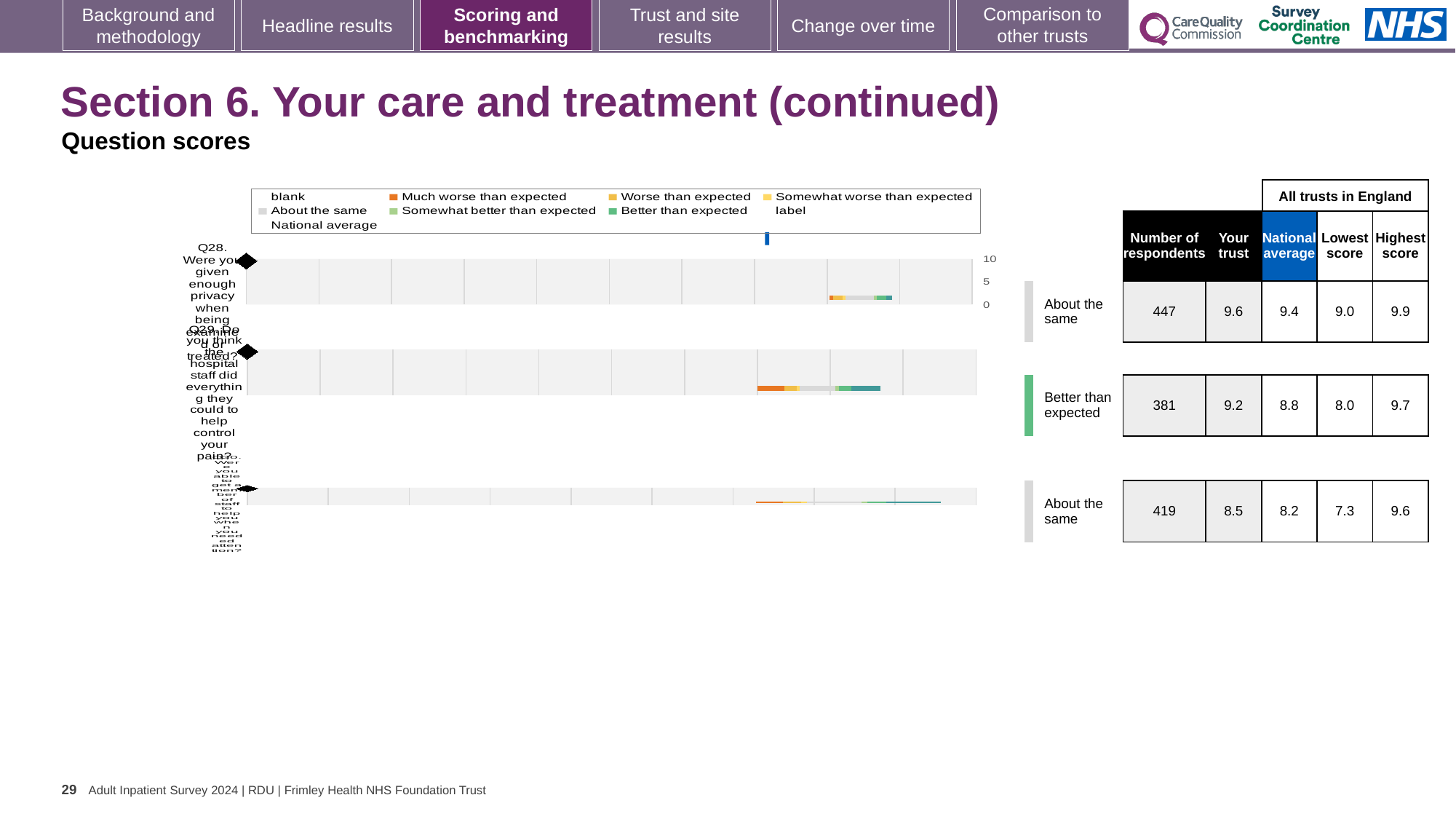
What benchmark category is shown for Q29? Better than expected What colour does the legend use for 'Much worse than expected'? Orange What is the highest score among all trusts in England for Q28? 9.9 What is the national average score for Q29 (staff did everything to help control your pain)? 8.8 Which question has the lowest 'Lowest score' across all trusts in England? Q30 What is the 'Your trust' score for Q28 (privacy when being examined or treated)? 9.6 How many questions are plotted on the slide? 3 For Q29, which is larger: the 'Your trust' score or the national average? Your trust How many respondents answered Q30? 419 What kind of chart is used to show the question scores? Bar chart What is the difference between the 'Your trust' score and the national average for Q30? 0.3 Which question has the highest 'Your trust' score? Q28